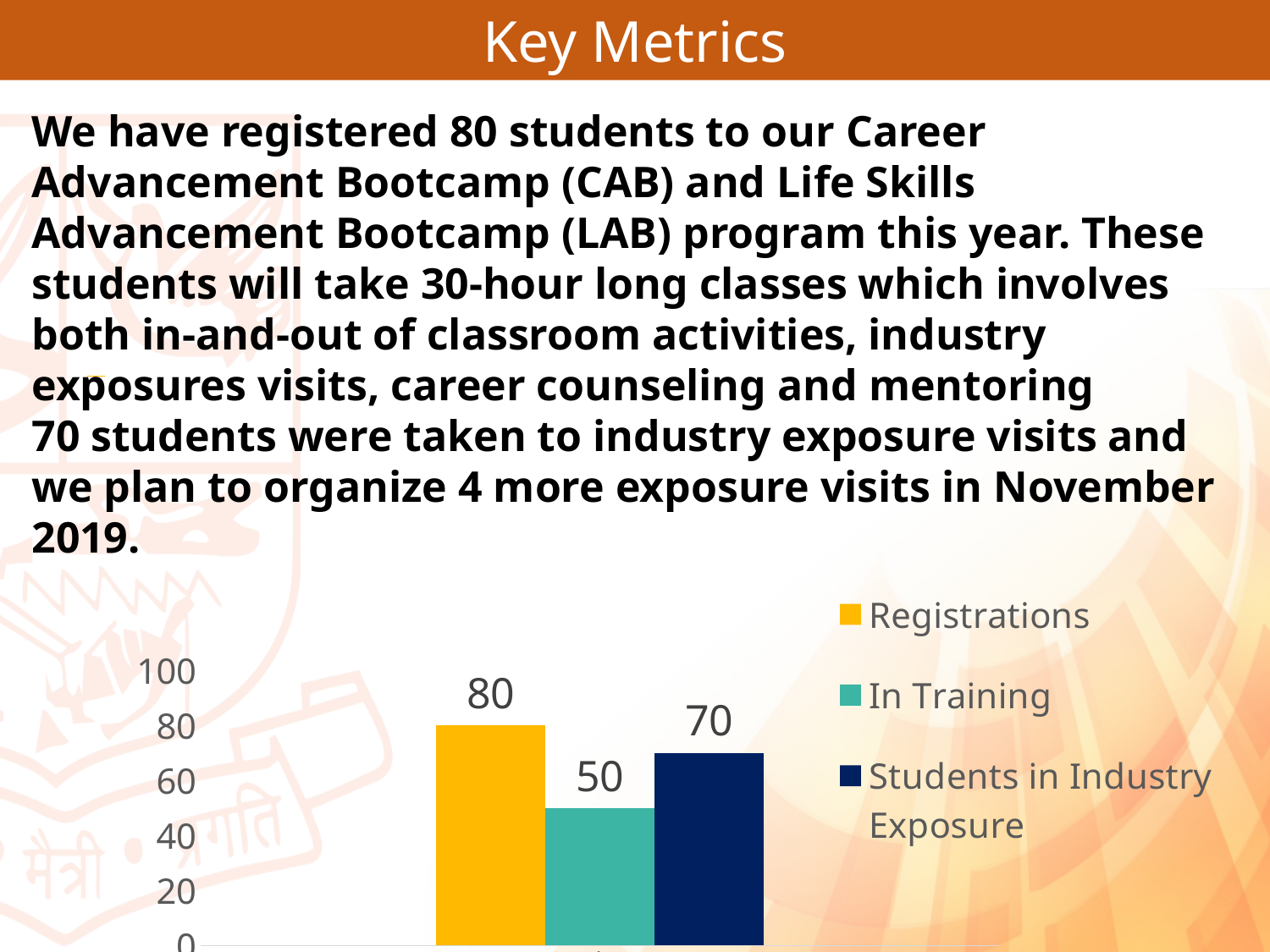
What colour is the bar for Students in Industry Exposure? dark blue Which series has the lowest value? In Training What is the value for Students in Industry Exposure? 70 How many series does the legend list? 3 What kind of chart is shown on the slide? bar chart Is the value for In Training greater or less than 60? less What is the difference between Registrations and In Training? 30 Which series has the highest value? Registrations What is the value for Registrations? 80 Which is larger, In Training or Students in Industry Exposure? Students in Industry Exposure What is the difference between Registrations and Students in Industry Exposure? 10 What is the value for In Training? 50